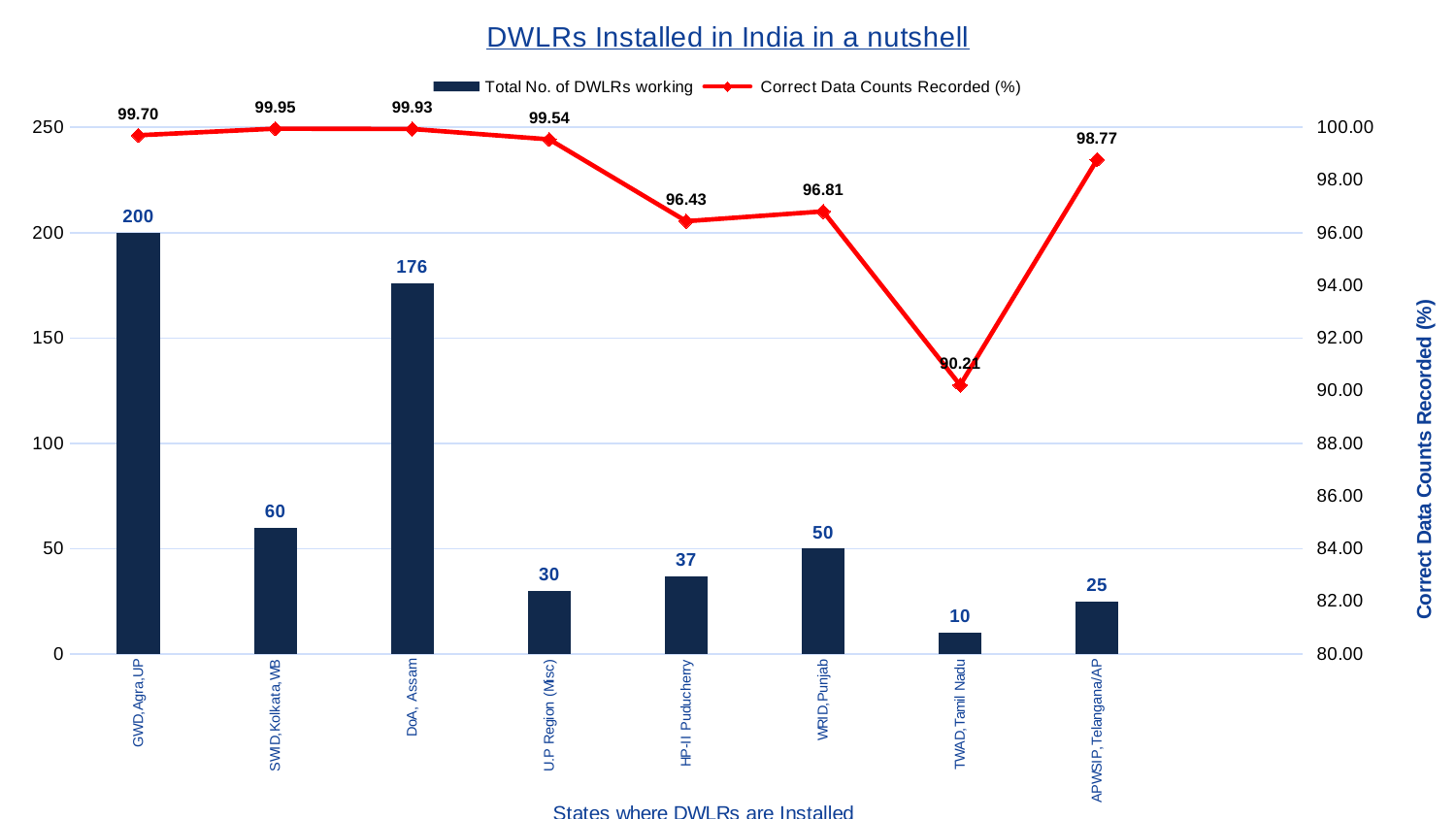
Which has more DWLRs working, SWID,Kolkata,WB or WRID,Punjab? SWID,Kolkata,WB What is the Correct Data Counts Recorded (%) for APWSIP,Telangana/AP? 98.77 What is the title of the chart? DWLRs Installed in India in a nutshell What is the difference in Total No. of DWLRs working between GWD,Agra,UP and DoA, Assam? 24 Which category has the lowest Correct Data Counts Recorded (%)? TWAD,Tamil Nadu What is the Correct Data Counts Recorded (%) for TWAD,Tamil Nadu? 90.21 What is the Total No. of DWLRs working for DoA, Assam? 176 How many categories are shown on the x axis? 8 What kind of chart is used for the Total No. of DWLRs working series? Bar chart Which category has the highest Total No. of DWLRs working? GWD,Agra,UP How many series does the legend list? 2 What is the Total No. of DWLRs working for GWD,Agra,UP? 200